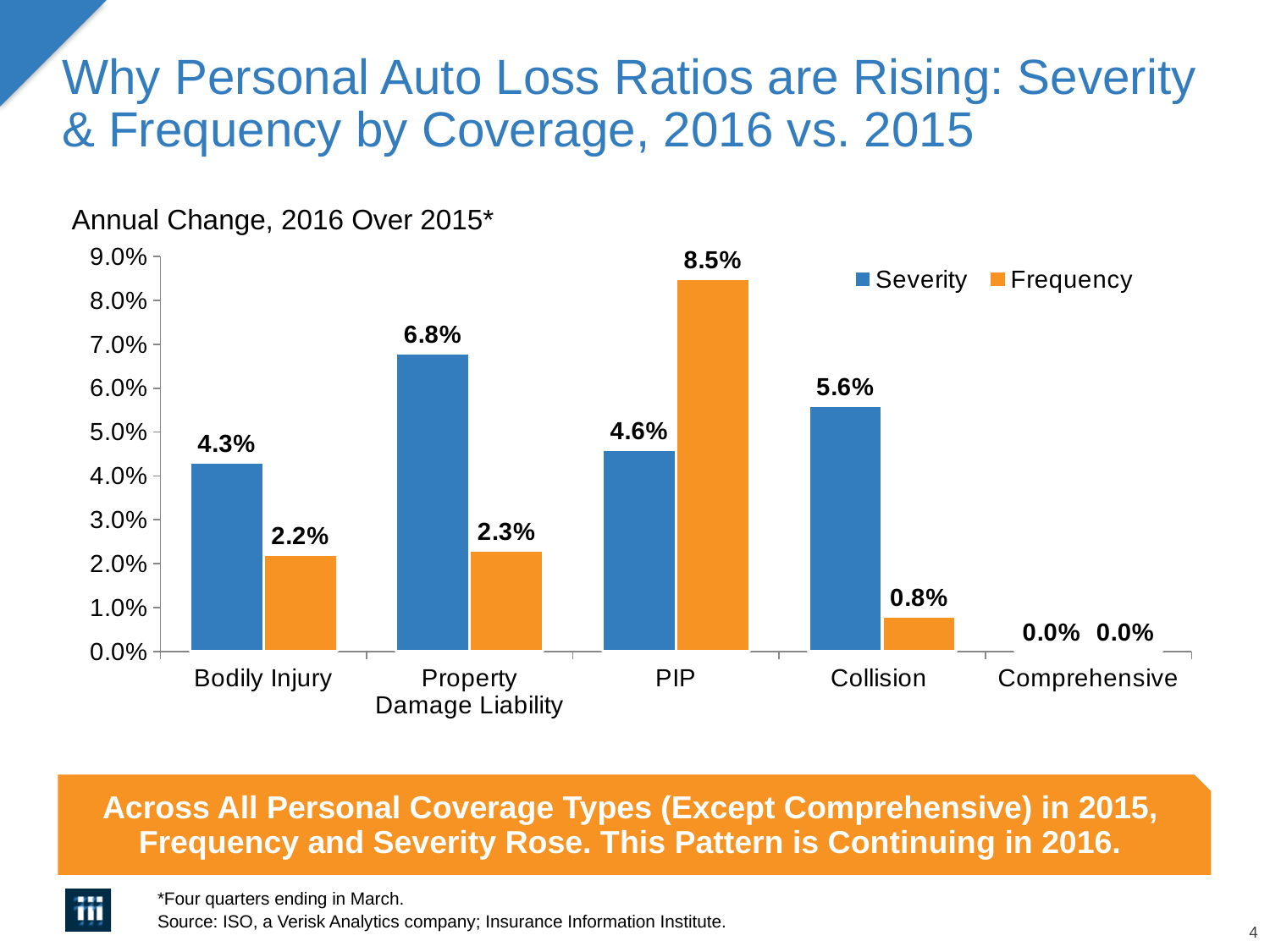
How many series does the legend list? 2 Which coverage has the highest Frequency value? PIP What is the difference between the Frequency and Severity values for PIP? 3.9% What colour are the Frequency bars? Orange Which is larger for Collision, Severity or Frequency? Severity What is the Frequency value for PIP? 8.5% What is the Frequency value for Collision? 0.8% What kind of chart is shown on the slide? Bar chart Which coverage has the lowest Severity value? Comprehensive How many coverage categories are shown on the x axis? 5 What is the Severity value for Bodily Injury? 4.3% Which coverage has the highest Severity value? Property Damage Liability